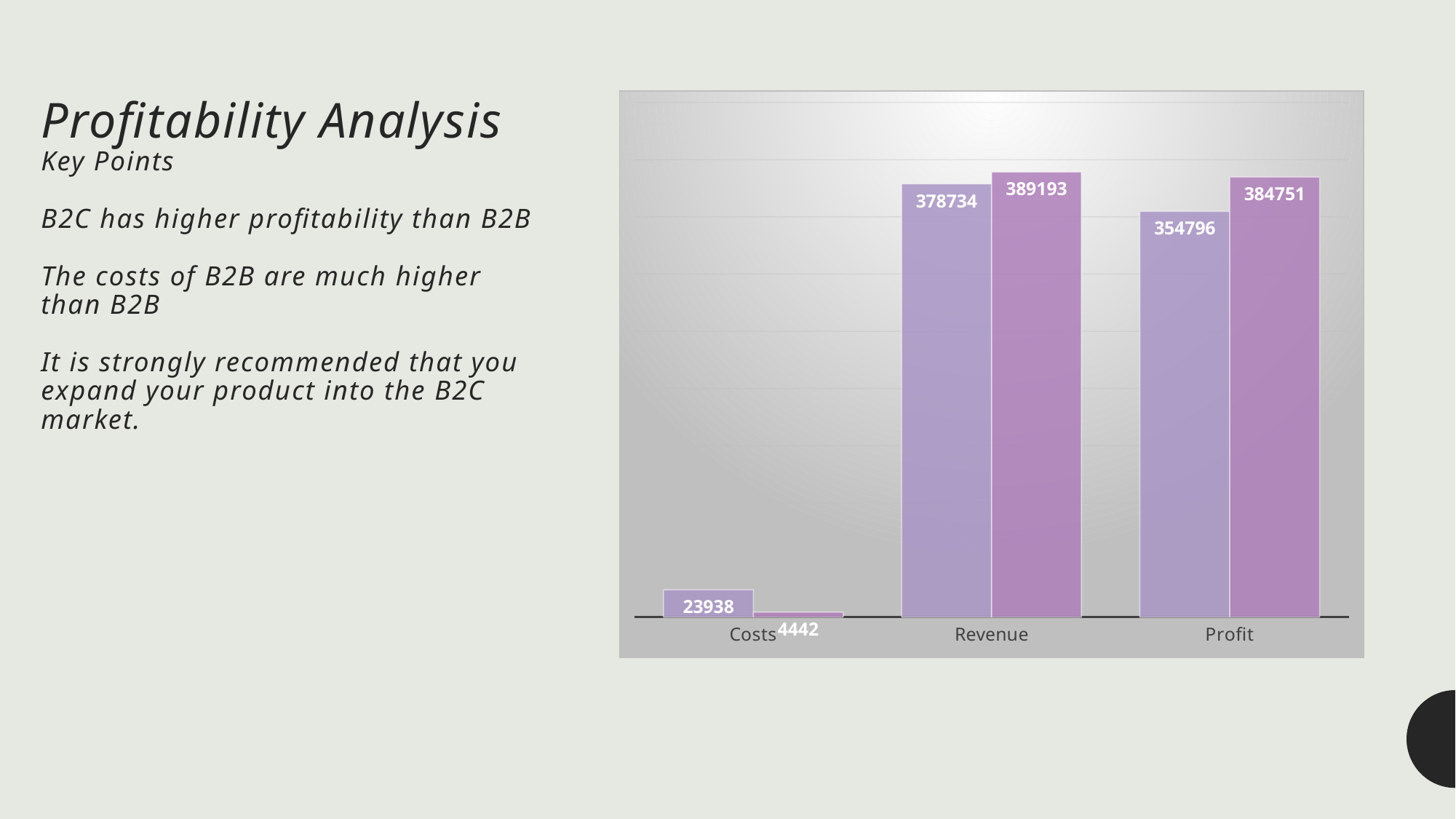
What is the value of the right (darker purple) bar for Profit? 384751 What is the value of the left (lighter purple) bar for Revenue? 378734 How many categories are shown on the x axis of the chart? 3 What is the value of the right (darker purple) bar for Revenue? 389193 What kind of chart is shown on the slide? bar chart What is the value of the right (darker purple) bar for Costs? 4442 Among the right (darker purple) bars, which category has the highest value? Revenue What is the value of the left (lighter purple) bar for Costs? 23938 Among the left (lighter purple) bars, which category has the lowest value? Costs For Profit, which bar is larger, the left (lighter purple) or the right (darker purple)? the right (darker purple) bar What is the difference between the left and right bars for Costs? 19496 What is the value of the left (lighter purple) bar for Profit? 354796